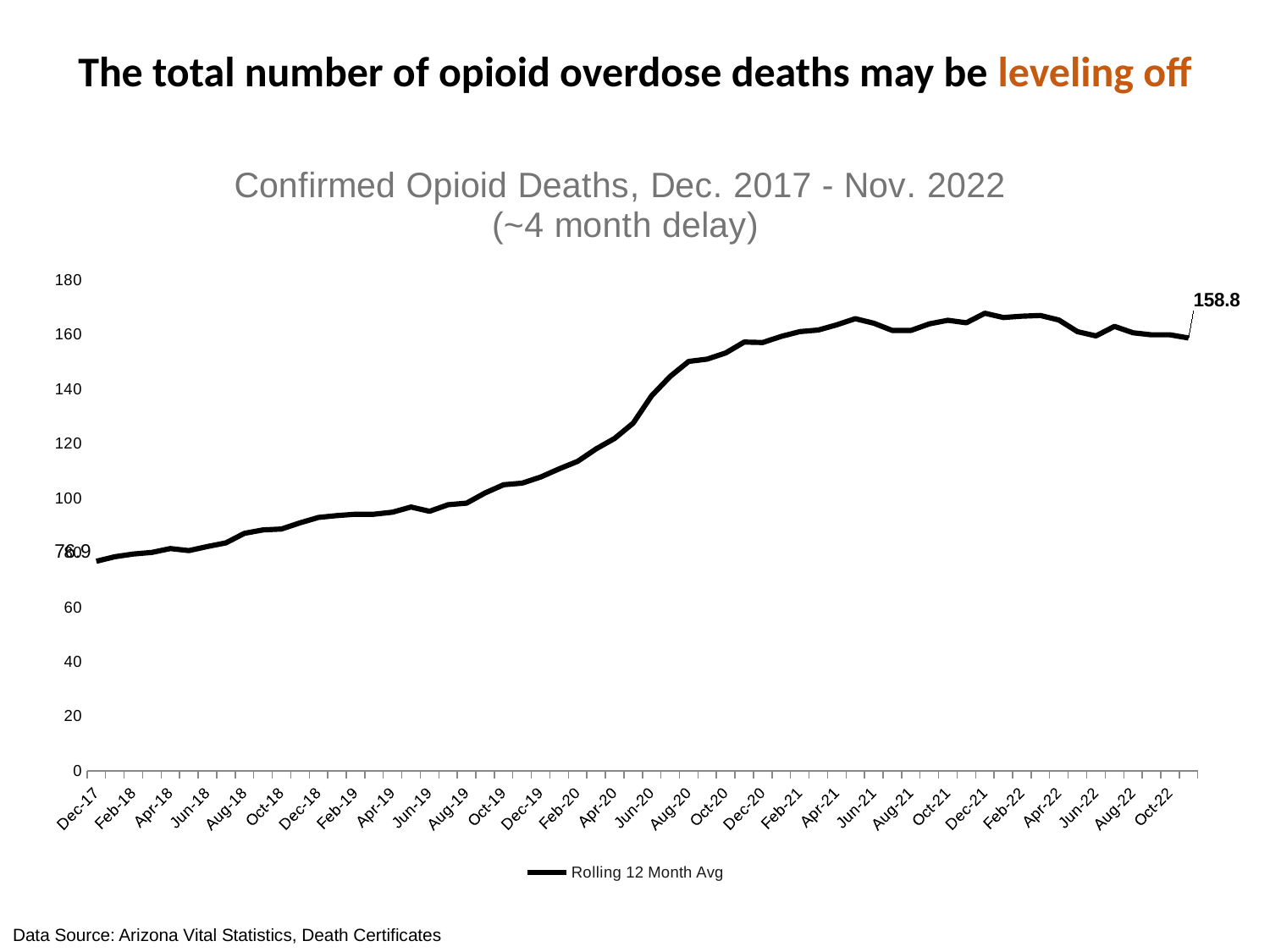
What kind of chart is shown on the slide? line chart How many series does the legend list? 1 Is the value for Jun-21 greater or less than 160? greater What is the value of the rolling 12 month average at the last point (Nov-22)? 158.8 Is the value for Aug-20 greater or less than 140? greater Is the value for Dec-19 greater or less than 120? less Overall, does the rolling 12 month average rise or fall from Dec-17 to Nov-22? rise What is the name of the series shown in the legend? Rolling 12 Month Avg Which is larger, the value for Jun-19 or the value for Jun-21? Jun-21 What is the chart's title? Confirmed Opioid Deaths, Dec. 2017 - Nov. 2022 (~4 month delay)